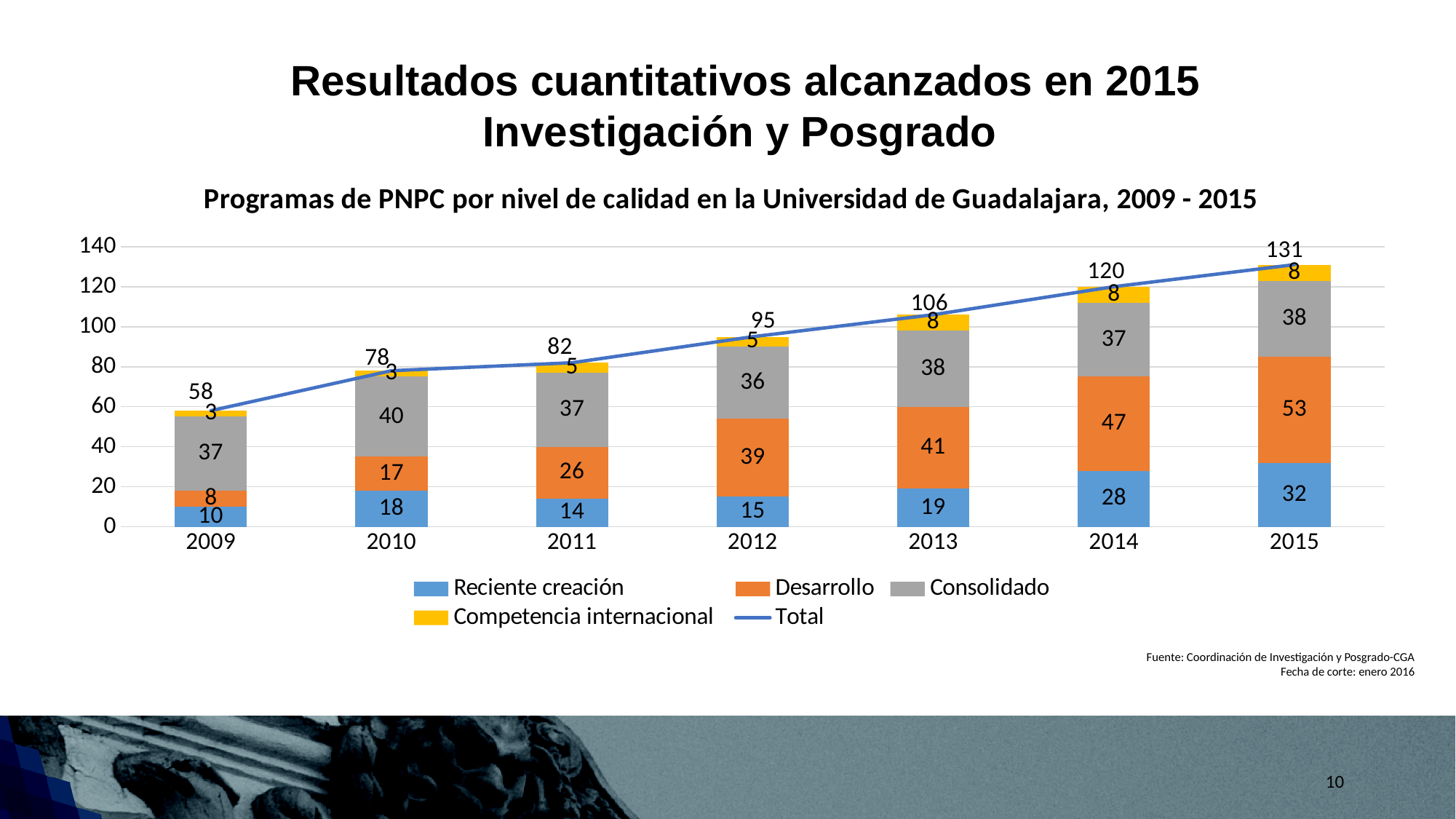
How many years are shown on the x axis? 7 How many series does the legend list? 5 Which year has the lowest value for Reciente creación? 2009 What is the difference between the Total for 2015 and the Total for 2009? 73 Does the Total rise or fall from 2009 to 2015? rise What is the title of the chart? Programas de PNPC por nivel de calidad en la Universidad de Guadalajara, 2009 - 2015 What is the Total for 2013? 106 Which is larger, Desarrollo in 2014 or Consolidado in 2014? Desarrollo in 2014 What is the value for Consolidado in 2010? 40 Which year has the highest Total? 2015 What is the value for Reciente creación in 2015? 32 What is the value for Desarrollo in 2012? 39